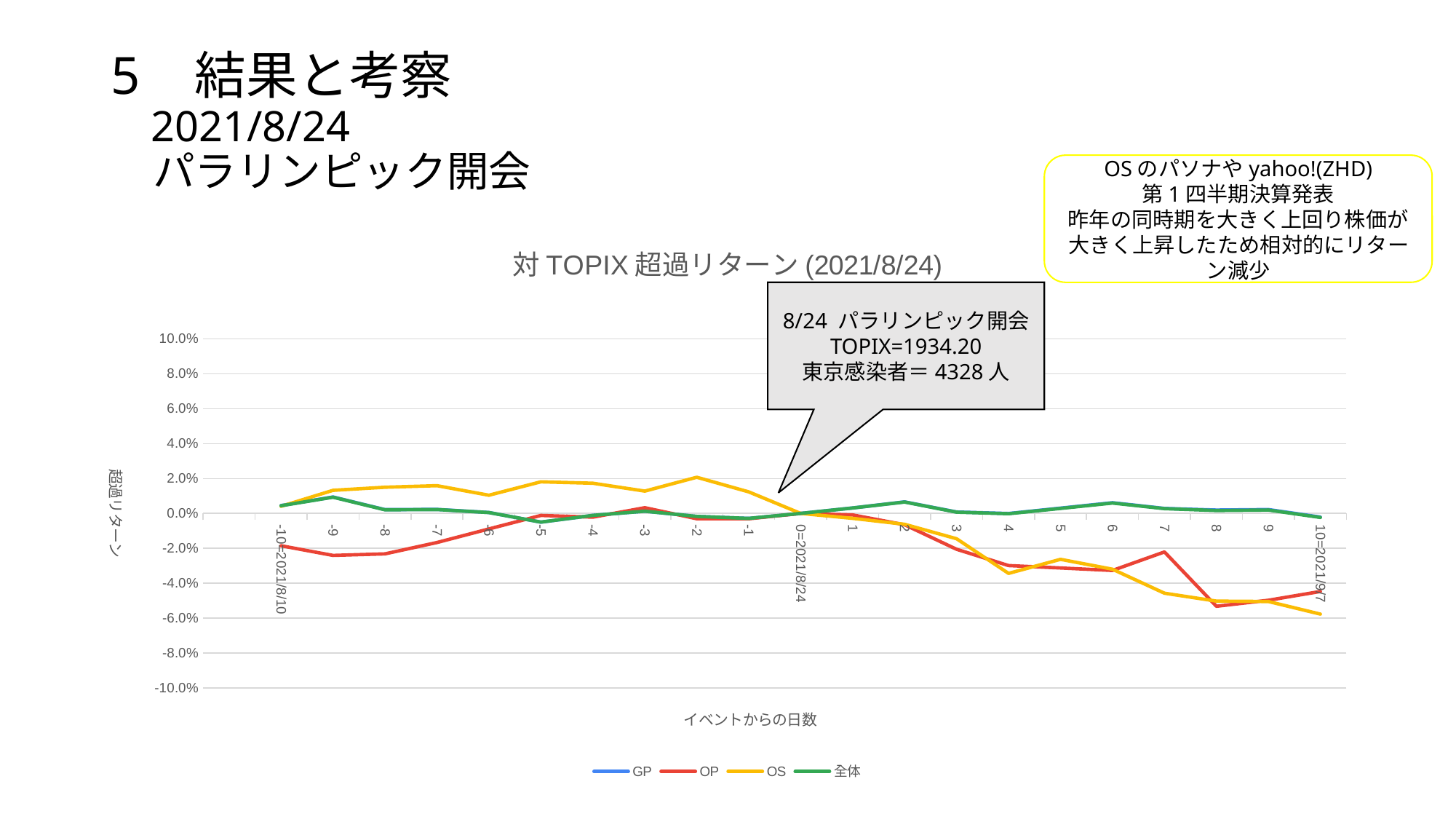
How many series does the legend list? 4 Is the value for OS at day 10 greater or less than -4.0%? less How many points are plotted along the x axis (from -10 to 10)? 21 What is the title of the chart? 対 TOPIX 超過リターン (2021/8/24) At day -10, which series has the higher value, OS or OP? OS What is the label of the x axis? イベントからの日数 Is the value for OS at day -5 greater or less than 0.0%? greater Which series has the lowest value at day 10? OS Is the value for OP at day -9 greater or less than 0.0%? less Does the OS series rise or fall from day 0 to day 10? fall What kind of chart is shown on the slide? line chart